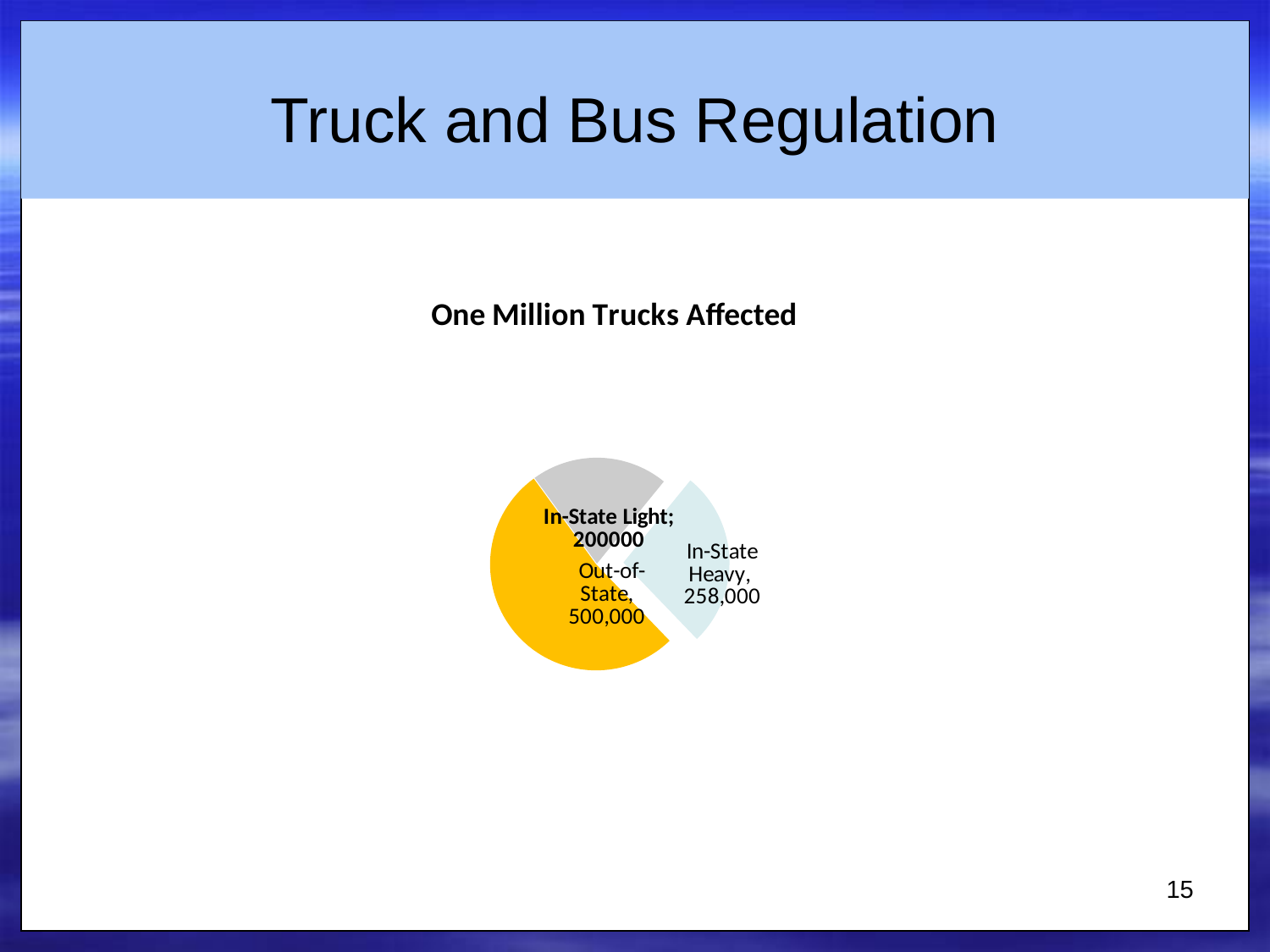
Which category has the smallest slice? In-State Light What type of chart is shown on the slide? Pie chart Which category has the largest slice? Out-of-State Which is larger, In-State Heavy or In-State Light? In-State Heavy What is the value for Out-of-State? 500,000 What is the difference between the In-State Heavy and In-State Light values? 58,000 What colour is the Out-of-State slice? Yellow What is the value for In-State Heavy? 258,000 How many slices does the pie chart have? 3 What is the difference between the Out-of-State and In-State Heavy values? 242,000 What is the value for In-State Light? 200000 What is the title of the chart? One Million Trucks Affected